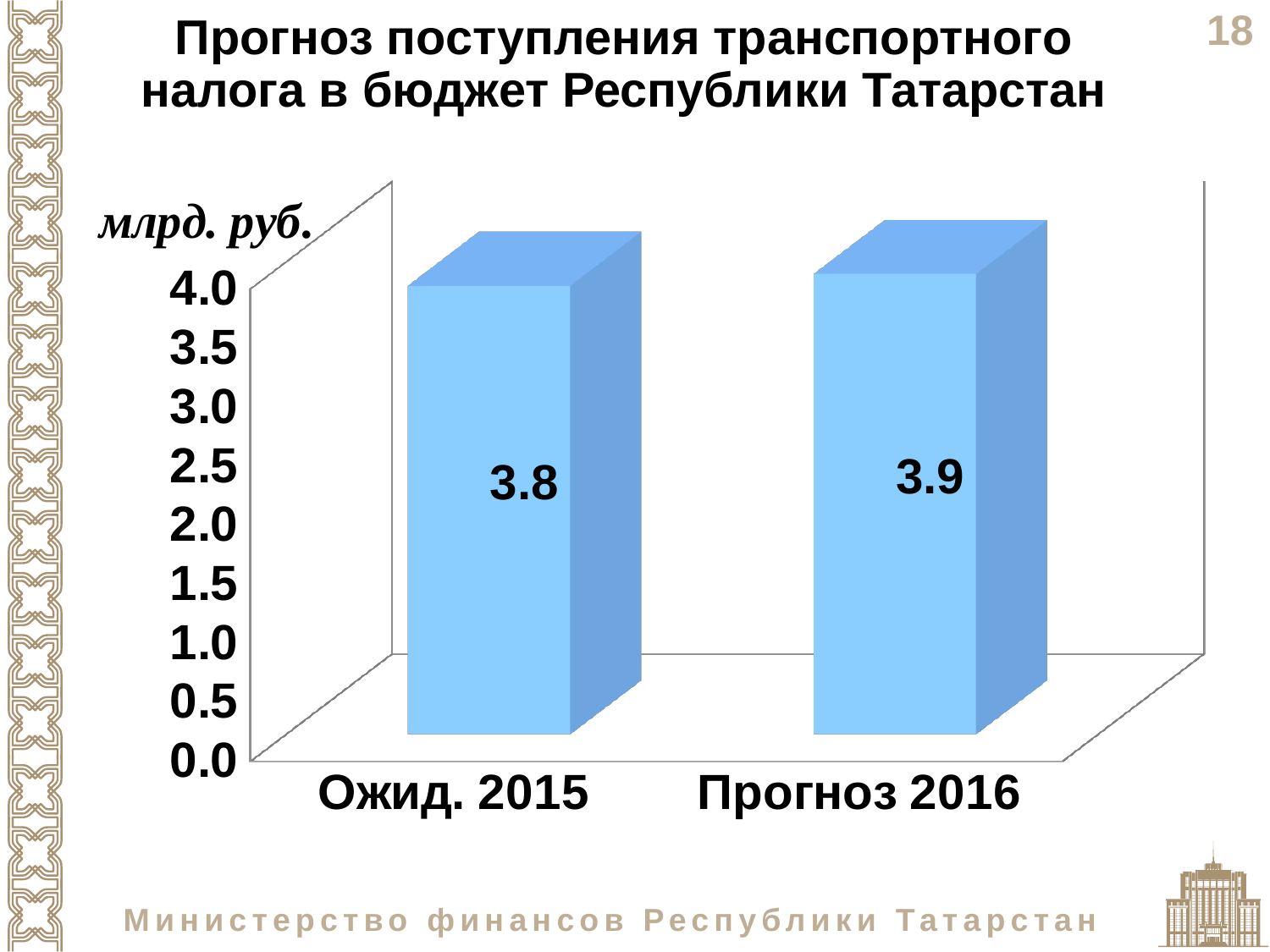
What is the value for Ожид. 2015? 3.8 What is the title of the chart? Прогноз поступления транспортного налога в бюджет Республики Татарстан What is the value for Прогноз 2016? 3.9 What kind of chart is shown on the slide? bar chart What is the difference between the values for Прогноз 2016 and Ожид. 2015? 0.1 How many categories are shown on the x axis? 2 Which is larger, the value for Ожид. 2015 or the value for Прогноз 2016? Прогноз 2016 Which category has the highest value? Прогноз 2016 Is the value for Ожид. 2015 greater or less than 3.0? greater Do the values rise or fall from Ожид. 2015 to Прогноз 2016? rise What unit is shown for the values on the chart? млрд. руб. Which category has the lowest value? Ожид. 2015